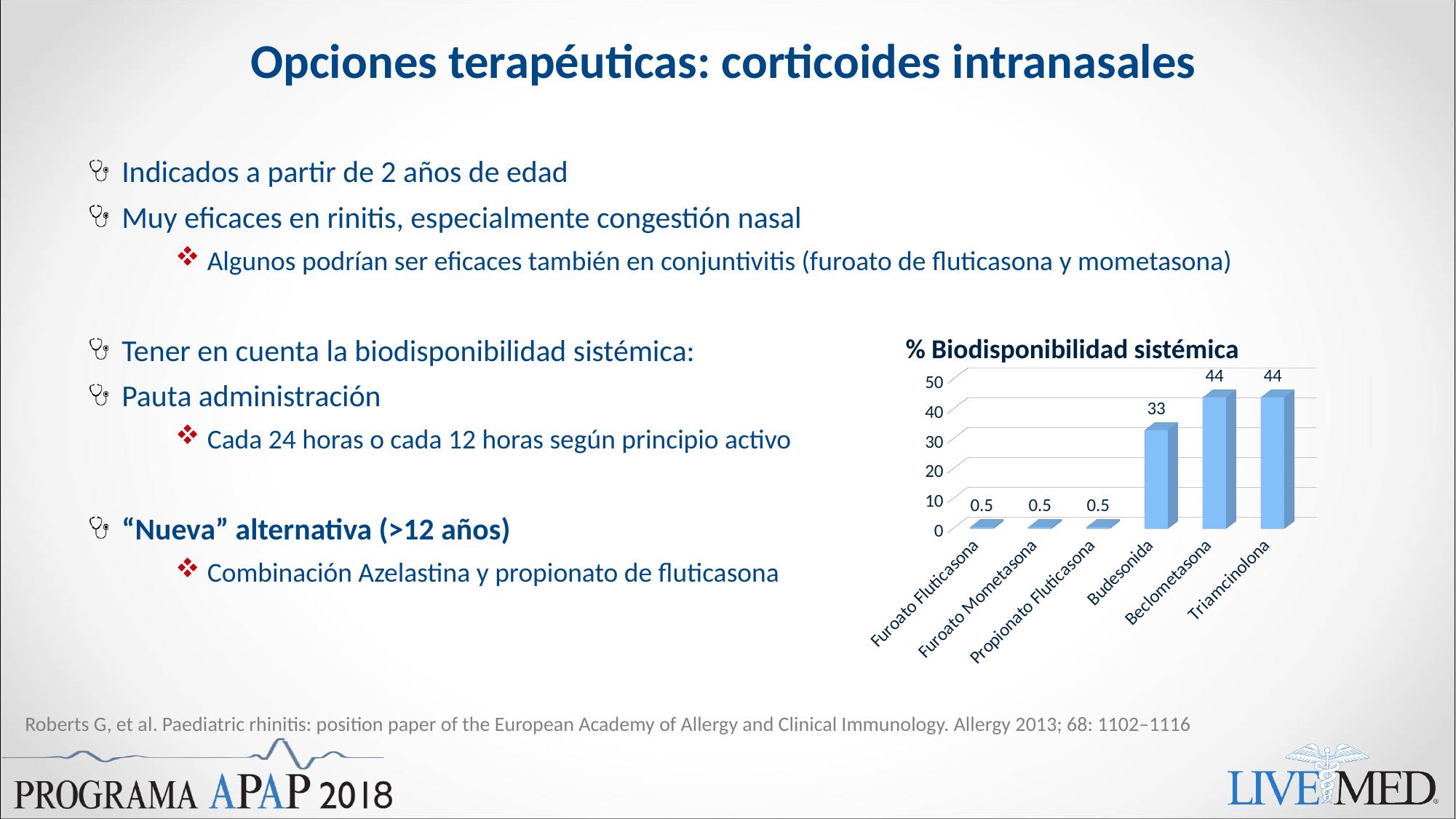
What is the value for Budesonida in the chart? 33 What is the value for Furoato Fluticasona in the chart? 0.5 What is the difference between the values for Beclometasona and Budesonida? 11 What is the difference between the values for Budesonida and Propionato Fluticasona? 32.5 Is the value for Budesonida greater or less than 40? less What kind of chart is shown on the slide? bar chart What is the value for Propionato Fluticasona in the chart? 0.5 Which is larger, the value for Budesonida or the value for Furoato Mometasona? Budesonida What is the title of the chart? % Biodisponibilidad sistémica How many categories are shown on the x axis of the chart? 6 Is the value for Beclometasona greater or less than 40? greater What is the value for Triamcinolona in the chart? 44